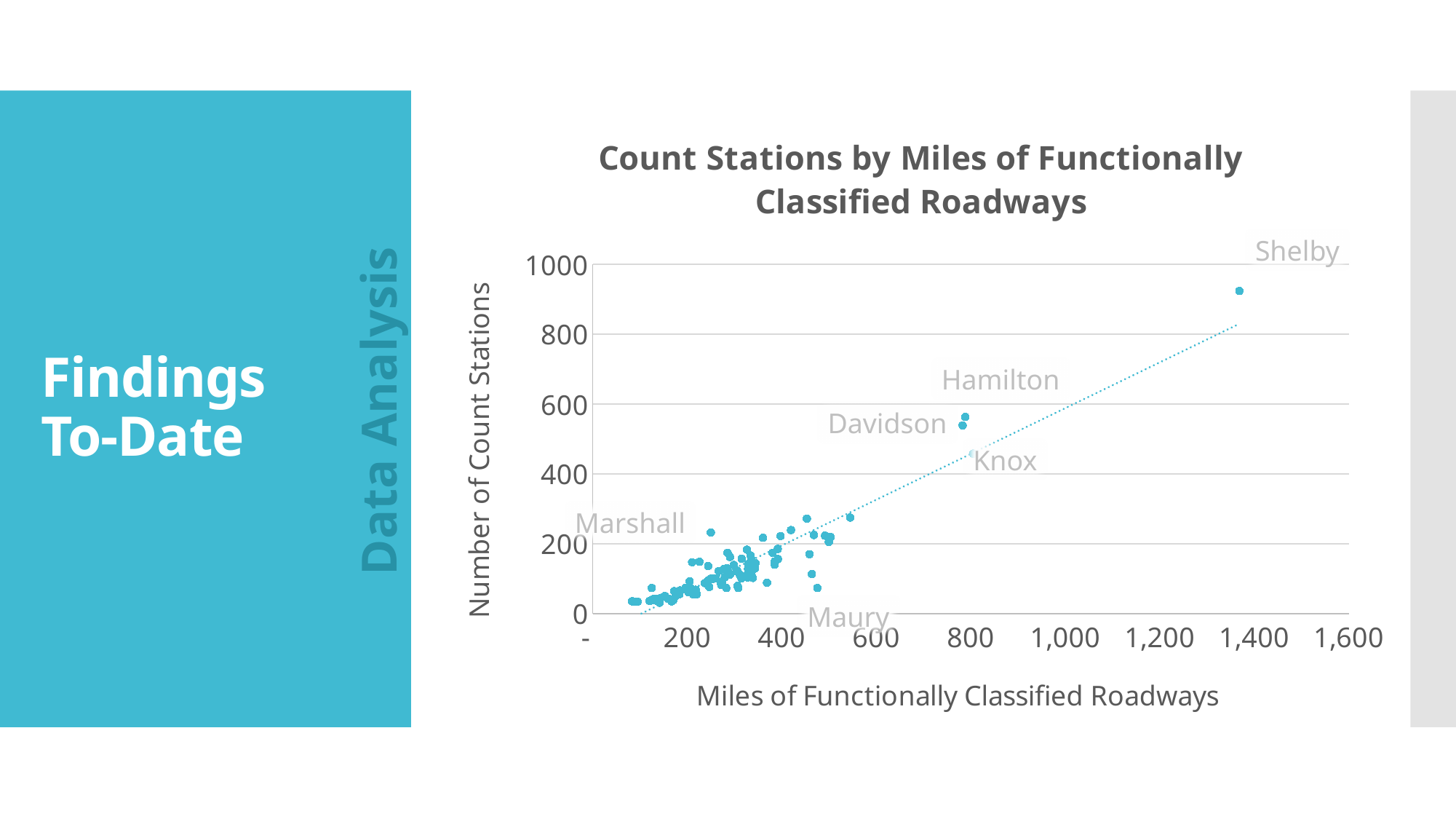
Is the number of count stations for Maury greater or less than 200? less Is the number of count stations for Knox greater or less than 400? greater Which has more count stations, Shelby or Knox? Shelby Which labeled county has the lowest number of count stations? Maury Is the number of count stations for Shelby greater or less than 800? greater What is the title of the chart? Count Stations by Miles of Functionally Classified Roadways As miles of functionally classified roadways increase, does the number of count stations generally rise or fall? rise What is the label of the vertical axis? Number of Count Stations What kind of chart is shown on the slide? scatter chart Which labeled county has the highest number of count stations? Shelby